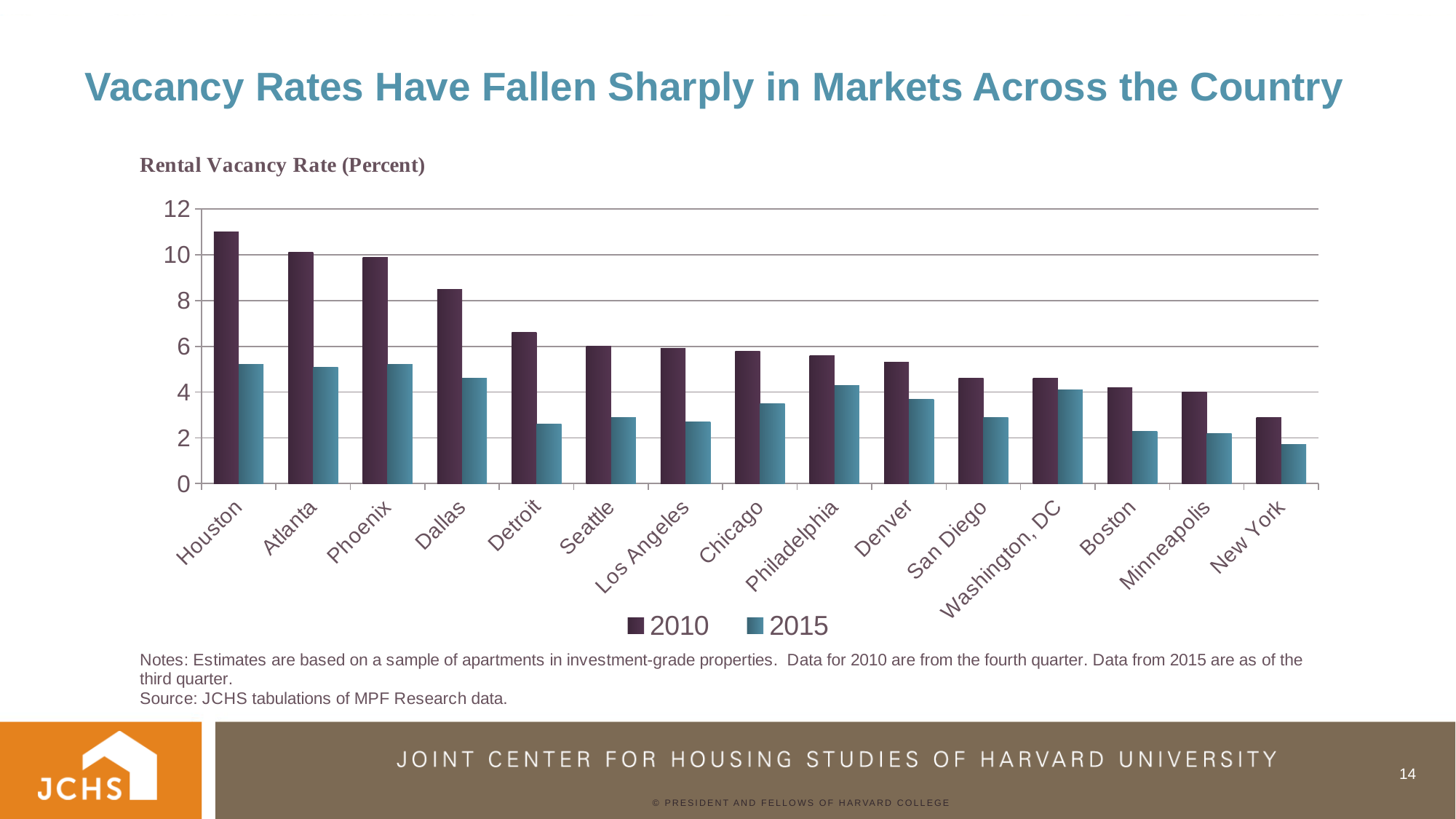
Which city has the lowest 2010 rental vacancy rate? New York What is the label of the vertical axis measure shown above the chart? Rental Vacancy Rate (Percent) Is the 2010 vacancy rate for Houston greater or less than 10? greater Which is larger for Chicago: the 2010 value or the 2015 value? 2010 Is the 2015 vacancy rate for Detroit greater or less than 4? less Which city has the lowest 2015 rental vacancy rate? New York Is the 2010 vacancy rate for Dallas greater or less than 8? greater Which city has the highest 2010 rental vacancy rate? Houston How many series does the legend list? 2 Do the 2010 vacancy rates rise or fall moving from left to right across the cities? fall What kind of chart is shown on the slide? bar chart How many cities are shown on the x axis of the chart? 15